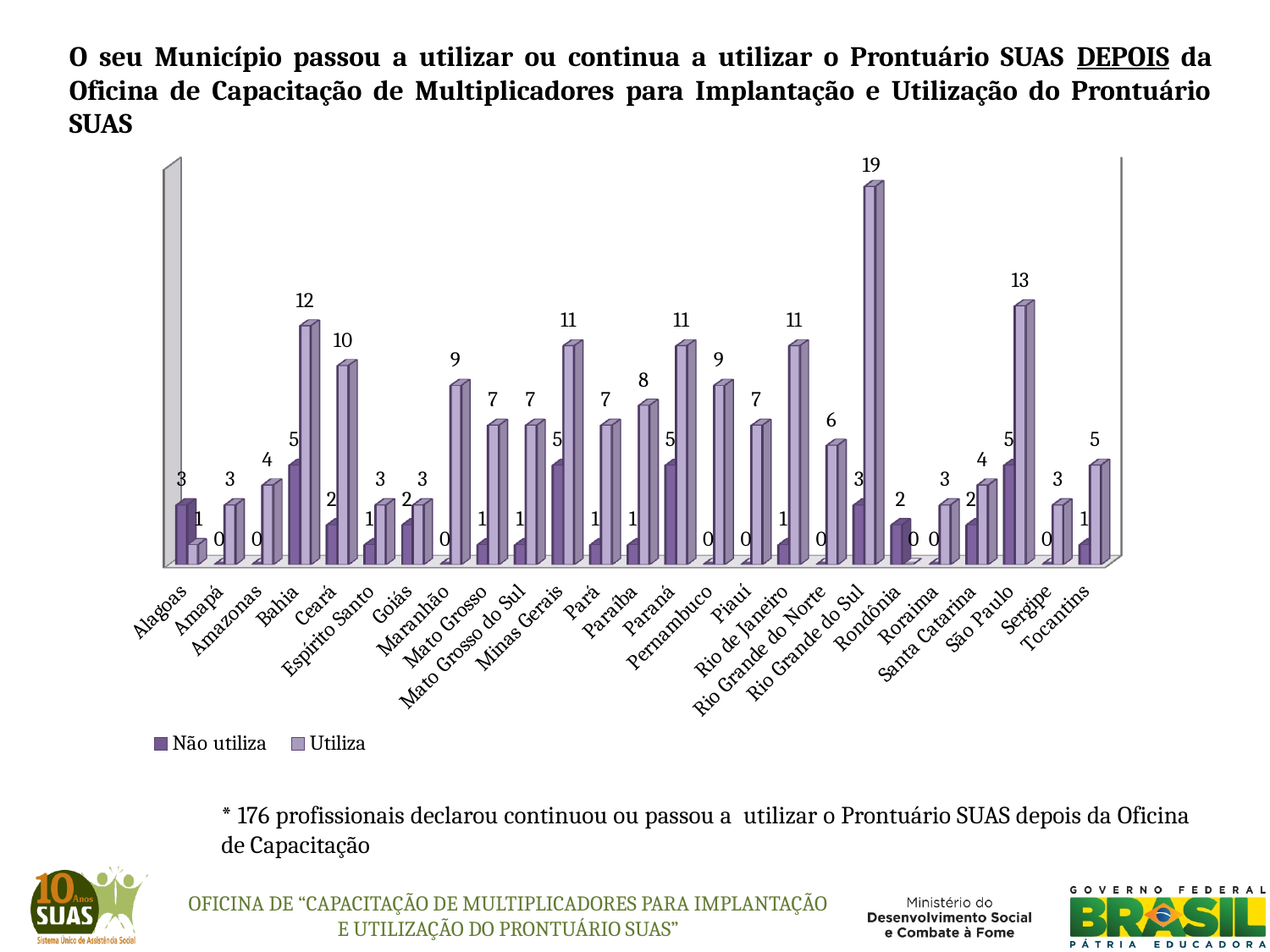
What type of chart is shown on the slide? bar chart What is the 'Utiliza' value for Maranhão? 9 What is the 'Não utiliza' value for Bahia? 5 Which state has the highest value for 'Utiliza'? Rio Grande do Sul Which state has the lowest value for 'Utiliza'? Rondônia How many series does the legend list? 2 What are the two legend entries of the chart? Não utiliza and Utiliza What is the 'Utiliza' value for São Paulo? 13 What is the 'Utiliza' value for Rio Grande do Sul? 19 How many states are shown on the x axis? 25 Which is larger for Alagoas: 'Não utiliza' or 'Utiliza'? Não utiliza What is the difference between the 'Utiliza' and 'Não utiliza' values for Ceará? 8